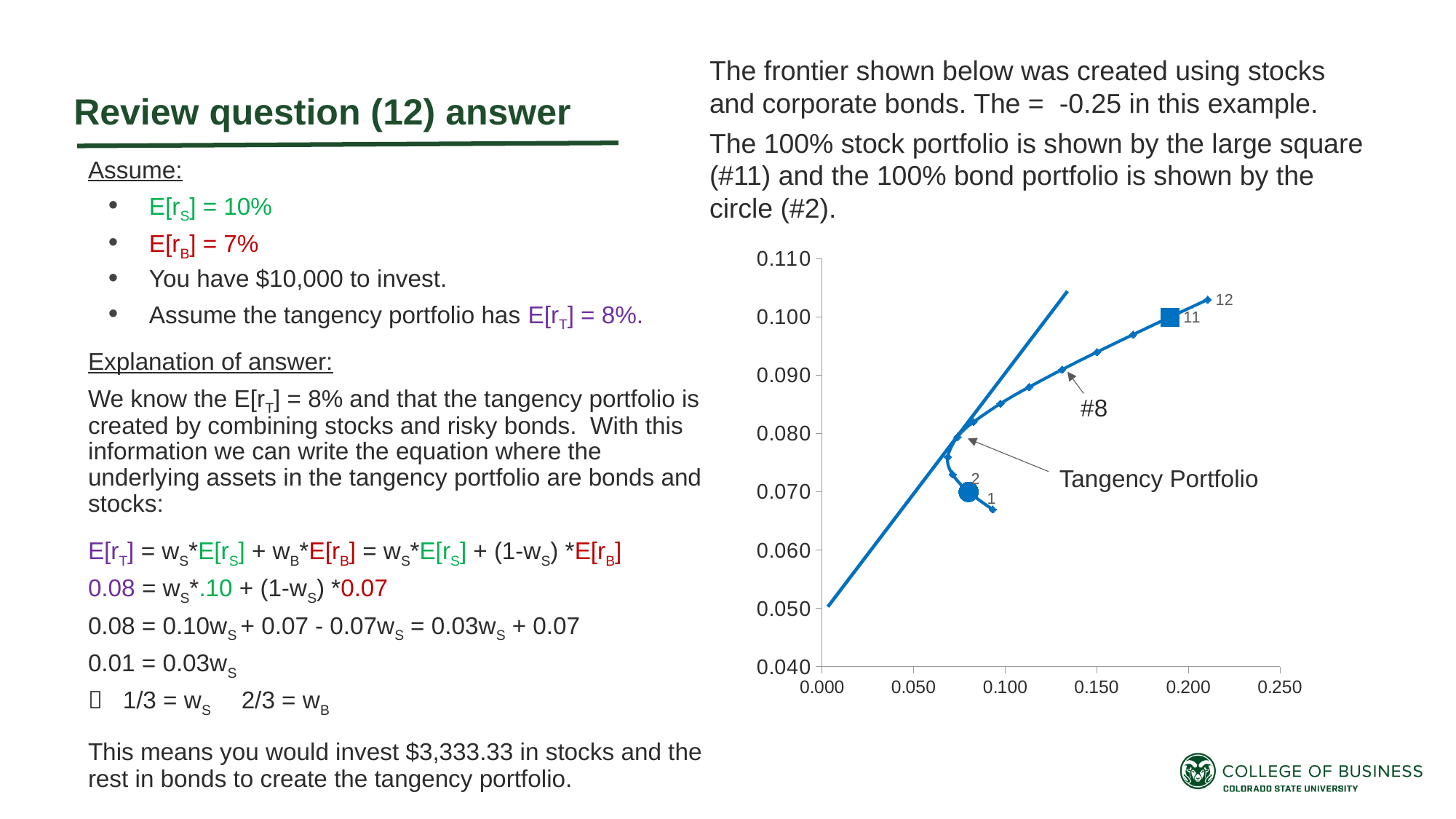
Which labeled point on the chart has the lowest y-axis value? 1 Which has the higher y-axis value on the chart, point 11 or point 2? point 11 Is the x-axis value of point 12 greater or less than 0.200? greater Is the x-axis value of point 2 greater or less than 0.100? less What marker shape represents the 100% stock portfolio on the chart? large square Moving along the frontier from point 2 to point 12, do the y-axis values rise or fall? rise Is the y-axis value of point 1 greater or less than 0.070? less Which labeled point on the chart has the highest y-axis value? 12 What kind of chart is shown on the slide? scatter chart What is the y-axis value of point 2 (the circle) on the chart? 0.070 What is the y-axis value of point 11 (the large square) on the chart? 0.100